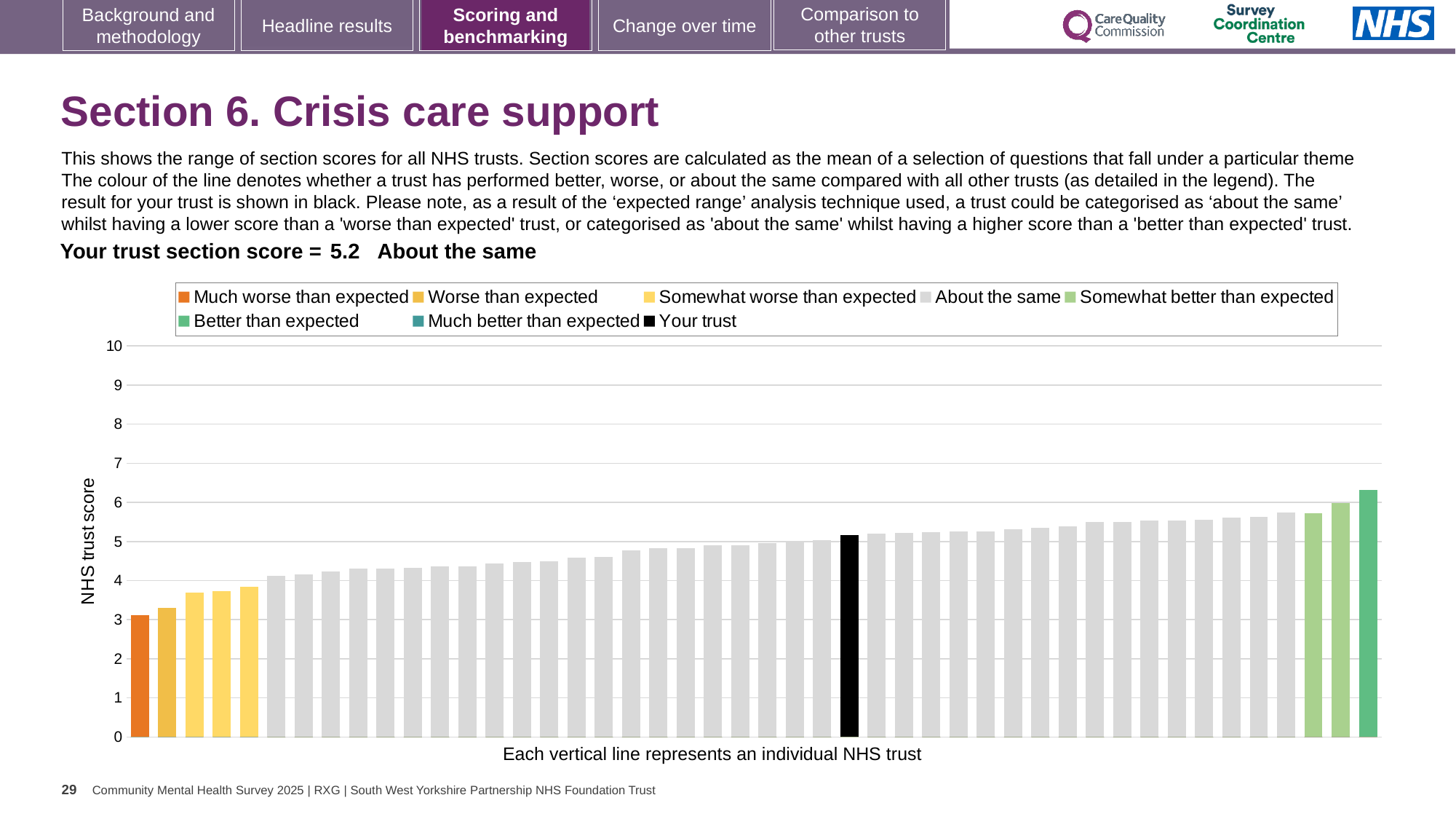
What kind of chart is shown on the slide? bar chart How many bars are coloured as 'Somewhat better than expected'? 2 Which legend category does the tallest bar belong to? Better than expected Is the value of the tallest bar greater or less than 6? greater Is the value of the shortest bar (the 'Much worse than expected' trust) greater or less than 4? less How many entries does the chart legend list? 8 Do the bar values rise or fall from left to right along the x axis? rise Is the value of the black 'Your trust' bar greater or less than 5? greater Which legend category does the shortest bar belong to? Much worse than expected What is the label on the y axis of the chart? NHS trust score What is the section score for your trust shown on the slide? 5.2 Which category is your trust's section score placed in? About the same